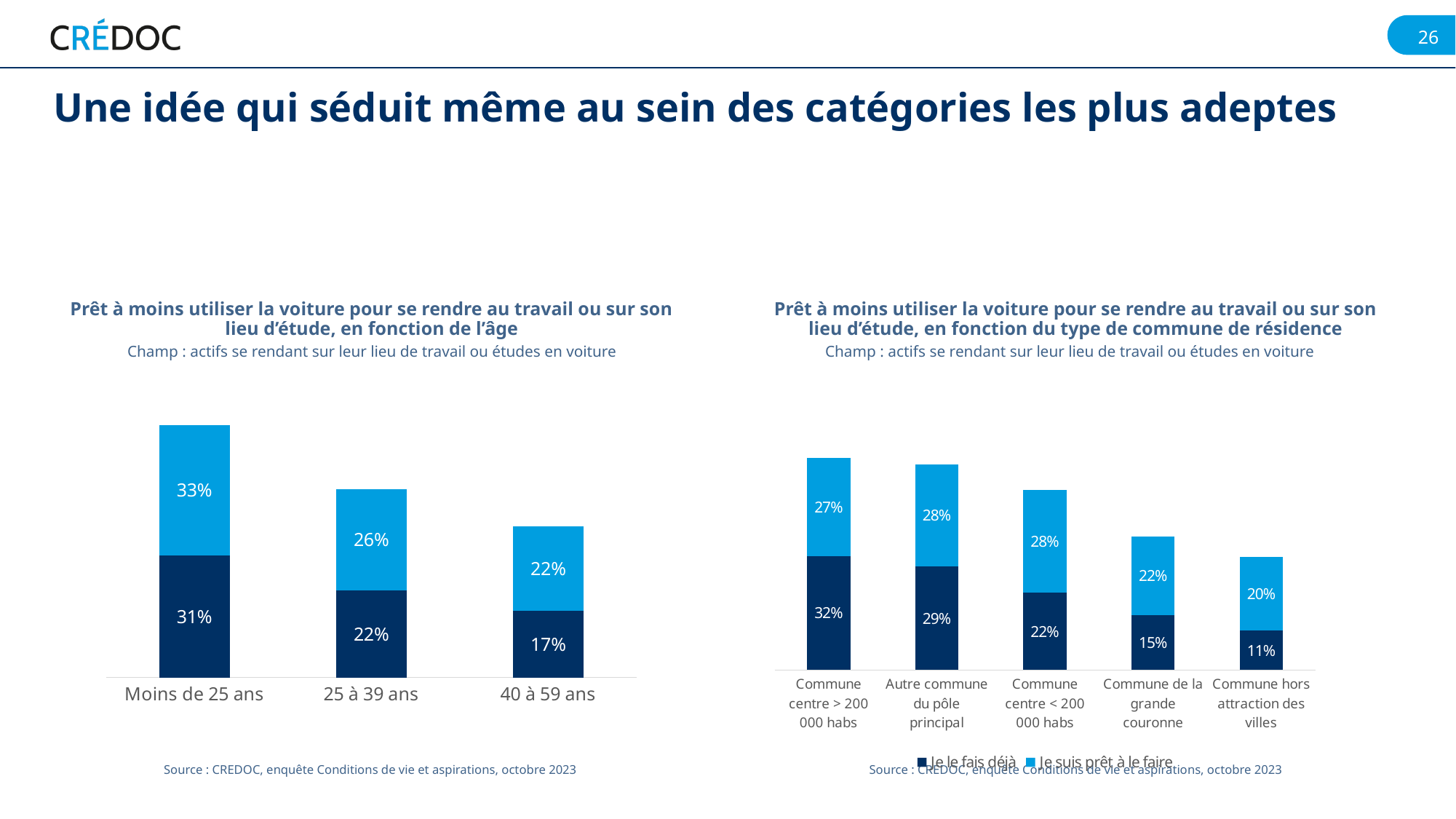
In the right chart (by type of commune), what is the total of the stacked bar for 'Commune de la grande couronne'? 37% In the left chart (by age), what is the value of the light blue top segment for '40 à 59 ans'? 22% In the right chart (by type of commune), which category has the lowest 'Je le fais déjà' value? Commune hors attraction des villes In the right chart (by type of commune), what is the value of 'Je suis prêt à le faire' for 'Commune centre < 200 000 habs'? 28% In the left chart (by age), what is the total height of the stacked bar for '25 à 39 ans'? 48% In the left chart (by age), how many age categories are shown? 3 In the right chart (by type of commune), how many series does the legend list? 2 In the right chart (by type of commune), what is the value of 'Je le fais déjà' for 'Commune hors attraction des villes'? 11% What type of chart is used on the right side of the slide? Stacked bar chart In the left chart (by age), what is the value of the dark blue bottom segment for 'Moins de 25 ans'? 31% In the left chart (by age), which age group has the highest total stacked bar? Moins de 25 ans In the left chart (by age), what is the difference between the dark blue segment for 'Moins de 25 ans' and for '40 à 59 ans'? 14 points